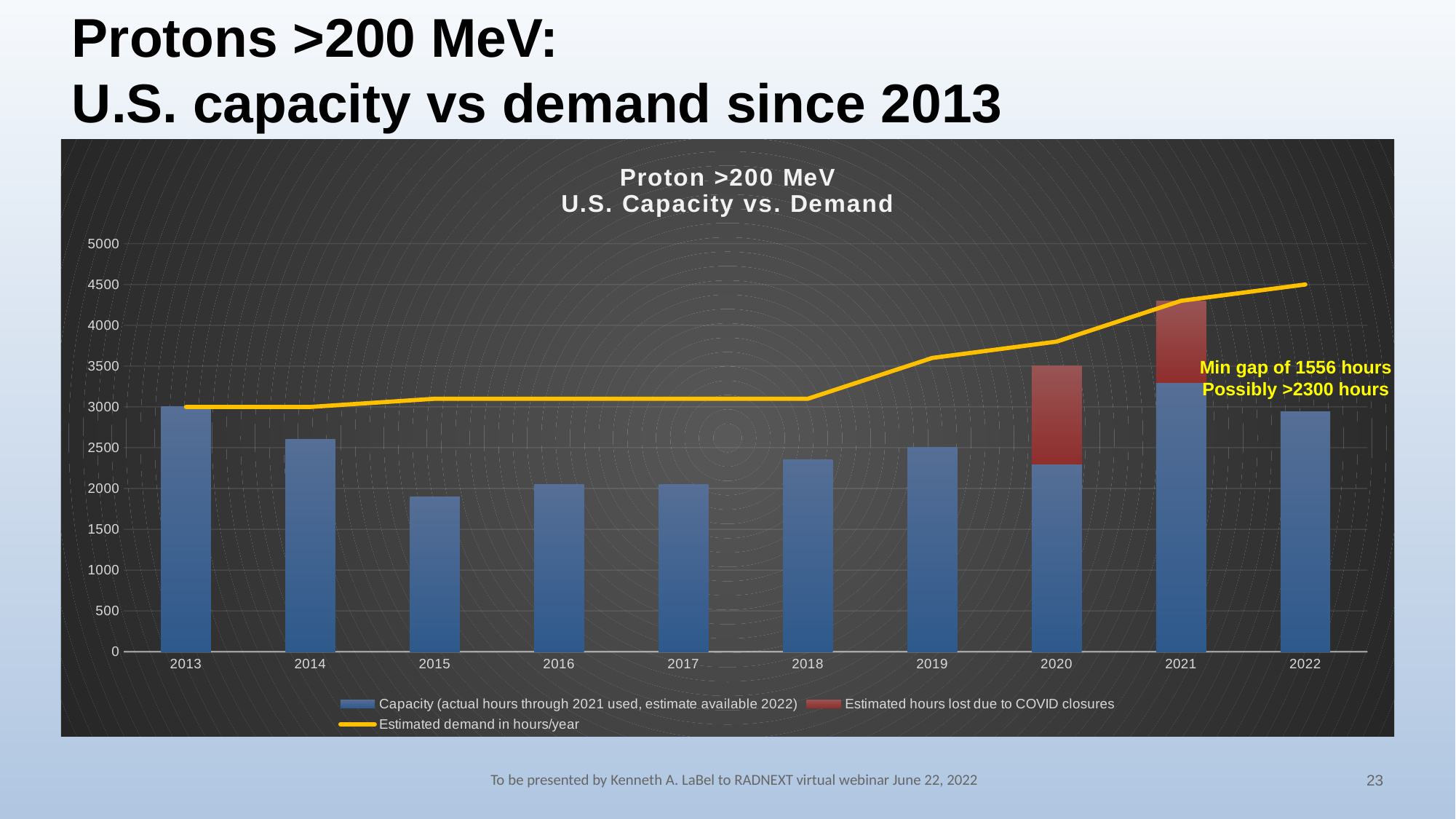
How many series does the chart legend list? 3 Is the estimated demand for 2022 greater or less than 4000? greater Does the estimated demand line rise or fall from 2018 to 2022? Rises What kind of chart is shown on the slide? Bar chart with a line Which year has the lowest capacity bar? 2015 Is the capacity value for 2015 greater or less than 2000? less Which year has the tallest blue capacity bar? 2021 Is the capacity bar for 2018 greater or less than 2500? less Which is larger, the capacity bar for 2013 or the capacity bar for 2019? 2013 Which years have red bars for estimated hours lost due to COVID closures? 2020 and 2021 How many years are shown on the x axis of the chart? 10